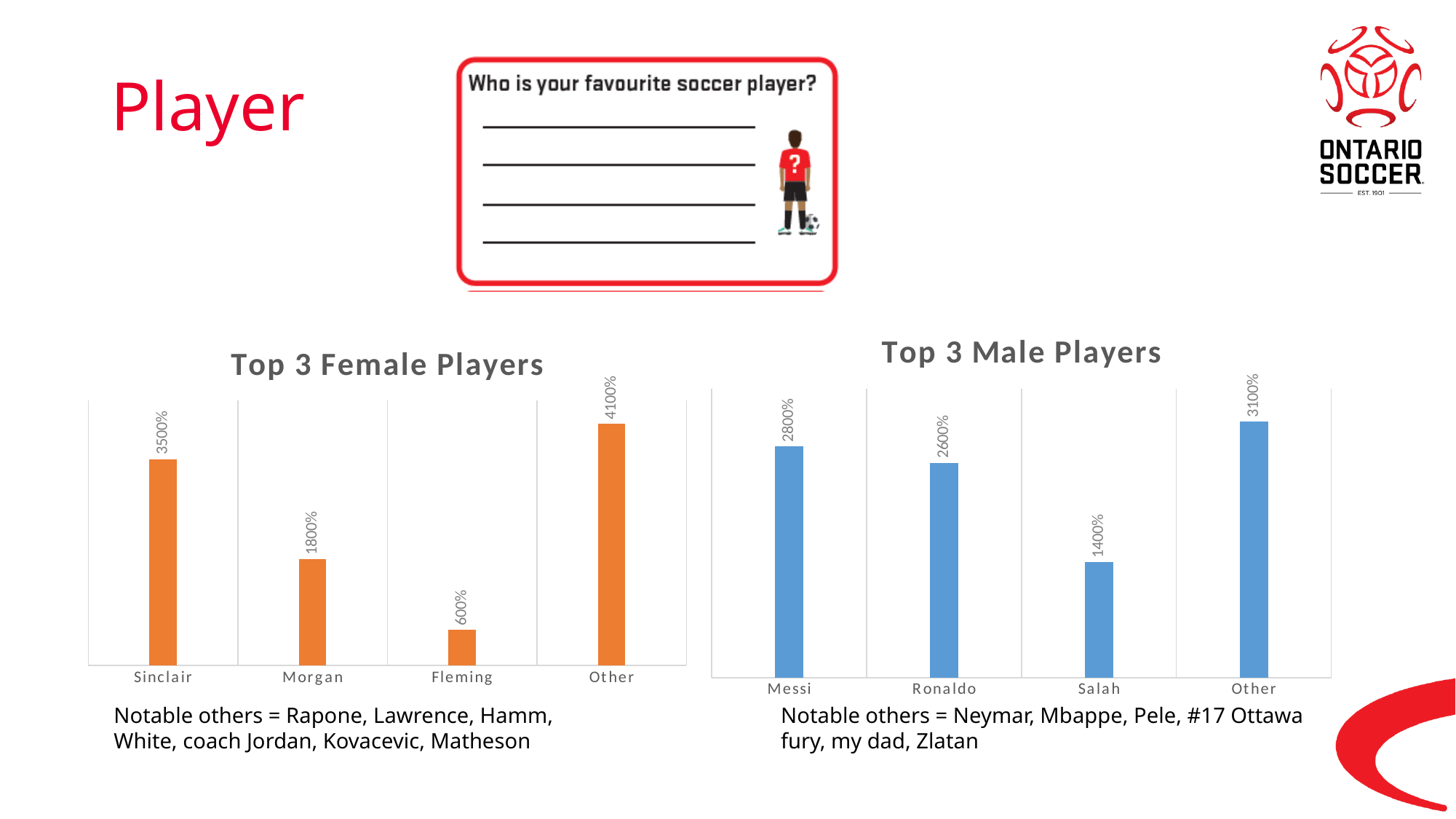
In the Top 3 Female Players chart, which is larger, the value for Morgan or the value for Fleming? Morgan In the Top 3 Male Players chart, what is the difference between the values for Other and Messi? 300% In the Top 3 Male Players chart, which named player has the highest value? Messi In the Top 3 Male Players chart, what is the value for Salah? 1400% In the Top 3 Female Players chart, what is the value for Fleming? 600% In the Top 3 Male Players chart, what is the value for Ronaldo? 2600% In the Top 3 Female Players chart, which category has the highest value? Other What kind of chart is the Top 3 Female Players chart? Bar chart How many categories are shown in the Top 3 Male Players chart? 4 In the Top 3 Female Players chart, what is the difference between the values for Sinclair and Morgan? 1700% In the Top 3 Female Players chart, what is the value for Sinclair? 3500% In the Top 3 Male Players chart, which category has the lowest value? Salah